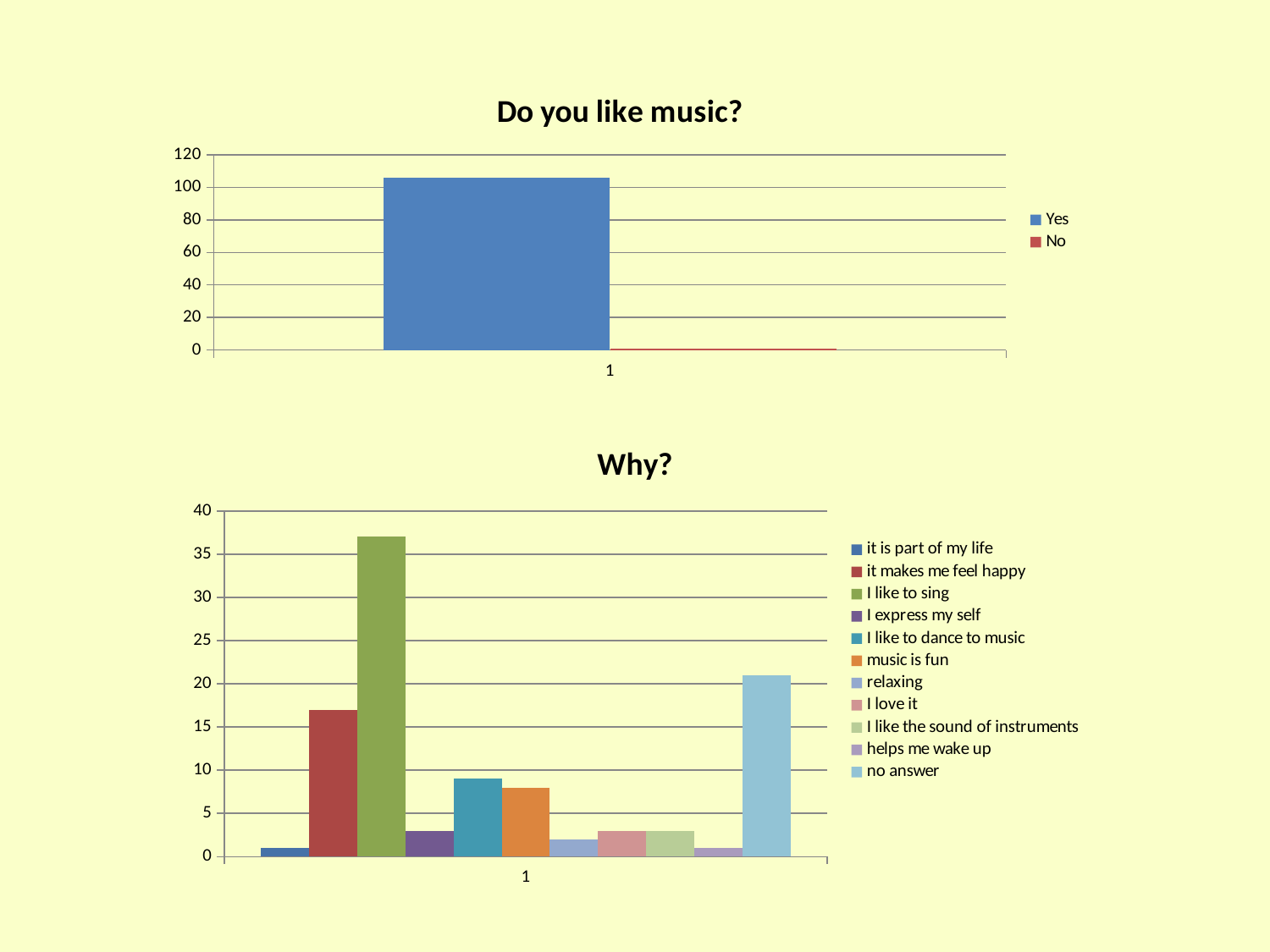
How many series does the legend of the "Do you like music?" chart list? 2 In the "Why?" chart, which series has the highest value? I like to sing What is the title of the lower chart on the slide? Why? In the "Why?" chart, which is larger, "it makes me feel happy" or "no answer"? no answer In the "Why?" chart, is the value for "no answer" greater or less than 20? greater In the "Why?" chart, is the value for "I like to dance to music" greater or less than 5? greater In the "Do you like music?" chart, which series has the higher value, Yes or No? Yes How many series does the legend of the "Why?" chart list? 11 What kind of chart is the "Do you like music?" chart? bar chart In the "Do you like music?" chart, is the value for Yes greater or less than 100? greater